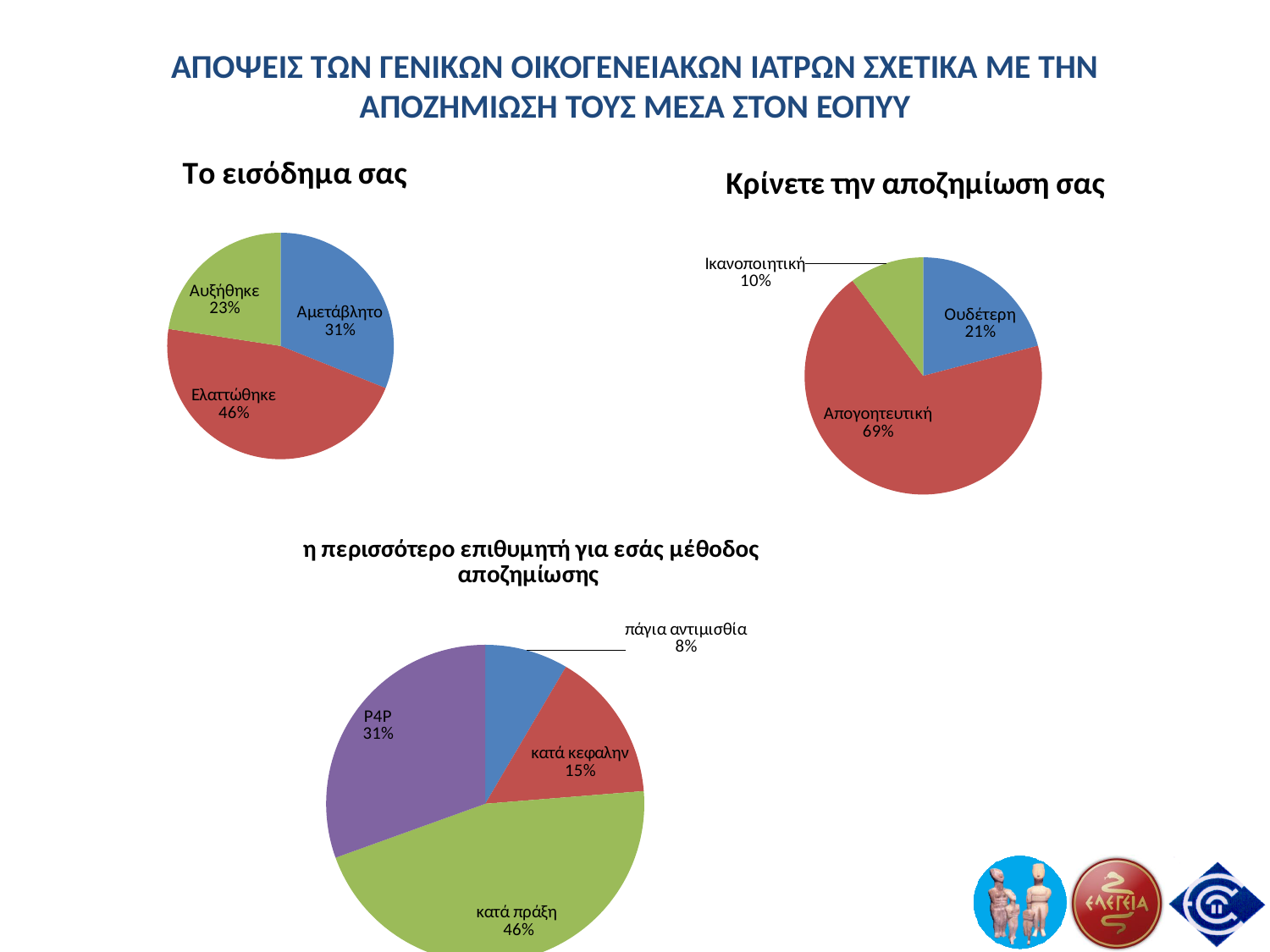
In the chart titled "Το εισόδημα σας", which category has the smallest share? Αυξήθηκε In the chart titled "η περισσότερο επιθυμητή για εσάς μέθοδος αποζημίωσης", what is the difference in percentage points between "κατά κεφαλην" and "πάγια αντιμισθία"? 7 In the chart titled "Κρίνετε την αποζημίωση σας", which category has the largest share? Απογοητευτική In the chart titled "Το εισόδημα σας", what percentage is shown for "Ελαττώθηκε"? 46% In the chart titled "Κρίνετε την αποζημίωση σας", what percentage is shown for "Απογοητευτική"? 69% In the chart titled "η περισσότερο επιθυμητή για εσάς μέθοδος αποζημίωσης", what percentage is shown for "P4P"? 31% In the chart titled "Το εισόδημα σας", what is the difference in percentage points between "Αμετάβλητο" and "Αυξήθηκε"? 8 What type of chart is the one titled "Το εισόδημα σας"? Pie chart In the chart titled "Κρίνετε την αποζημίωση σας", how many categories are shown? 3 In the chart titled "η περισσότερο επιθυμητή για εσάς μέθοδος αποζημίωσης", which category has the largest share? κατά πράξη In the chart titled "Κρίνετε την αποζημίωση σας", which is larger: "Ουδέτερη" or "Ικανοποιητική"? Ουδέτερη In the chart titled "η περισσότερο επιθυμητή για εσάς μέθοδος αποζημίωσης", how many categories are shown? 4